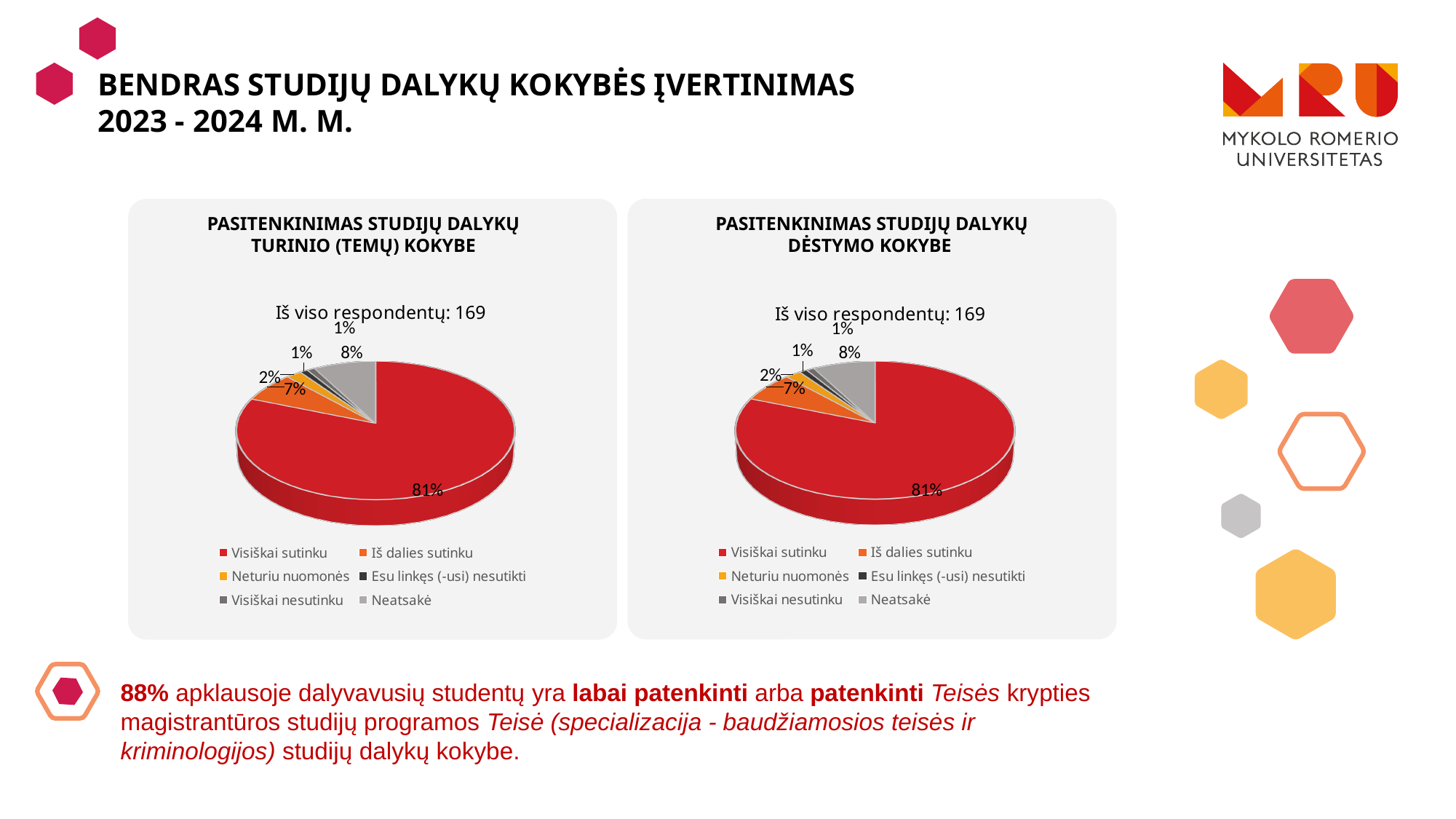
In the chart titled "Pasitenkinimas studijų dalykų turinio (temų) kokybe", what share of respondents is labelled "Neatsakė"? 8% In the chart titled "Pasitenkinimas studijų dalykų turinio (temų) kokybe", what colour is the "Visiškai sutinku" slice? Red In the chart titled "Pasitenkinimas studijų dalykų turinio (temų) kokybe", what share of respondents answered "Visiškai sutinku"? 81% In the chart titled "Pasitenkinimas studijų dalykų dėstymo kokybe", what share of respondents answered "Iš dalies sutinku"? 7% In the chart titled "Pasitenkinimas studijų dalykų turinio (temų) kokybe", which is larger: "Iš dalies sutinku" or "Neatsakė"? Neatsakė In the chart titled "Pasitenkinimas studijų dalykų dėstymo kokybe", what share of respondents answered "Neturiu nuomonės"? 2% What kind of chart is used for "Pasitenkinimas studijų dalykų turinio (temų) kokybe"? Pie chart How many categories does the legend of the chart titled "Pasitenkinimas studijų dalykų dėstymo kokybe" list? 6 In the chart titled "Pasitenkinimas studijų dalykų dėstymo kokybe", what is the difference in percentage points between "Visiškai sutinku" and "Neatsakė"? 73 How many respondents in total are reported for the chart titled "Pasitenkinimas studijų dalykų dėstymo kokybe"? 169 In the chart titled "Pasitenkinimas studijų dalykų dėstymo kokybe", what is the combined share of "Visiškai sutinku" and "Iš dalies sutinku"? 88% In the chart titled "Pasitenkinimas studijų dalykų turinio (temų) kokybe", which category has the largest slice? Visiškai sutinku